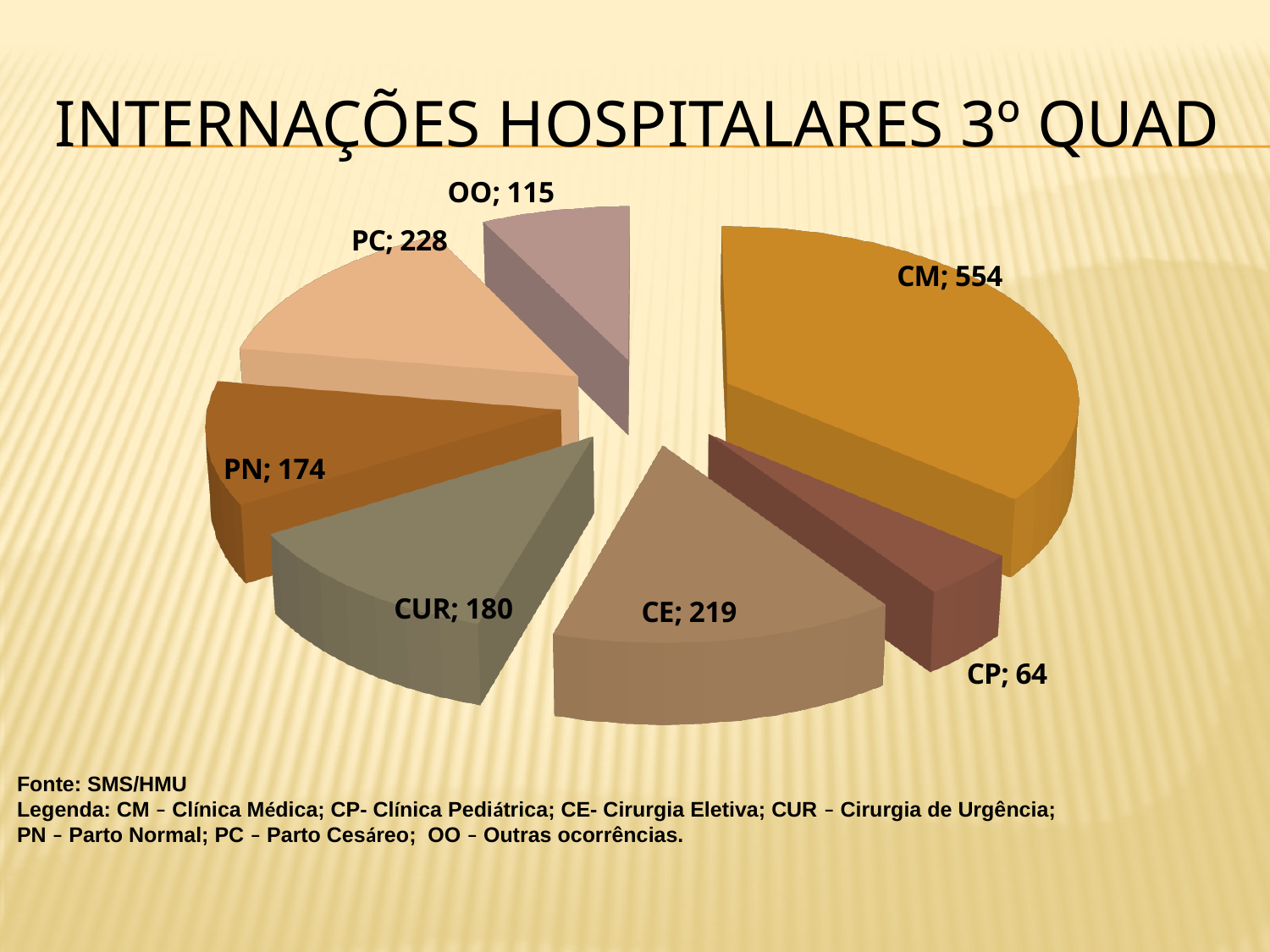
Which category has the largest slice in the pie chart? CM What kind of chart is shown on the slide? pie chart According to the legend text on the slide, what does PN stand for? Parto Normal What is the difference between the values for CM and CE? 335 Which is larger, the value for CE or the value for PC? PC Which category has the smallest slice in the pie chart? CP What is the title of the slide containing the pie chart? INTERNAÇÕES HOSPITALARES 3º QUAD What is the value for OO in the pie chart? 115 What is the value for CUR in the pie chart? 180 What is the difference between the values for PC and OO? 113 How many slices does the pie chart have? 7 What is the value for CM in the pie chart? 554